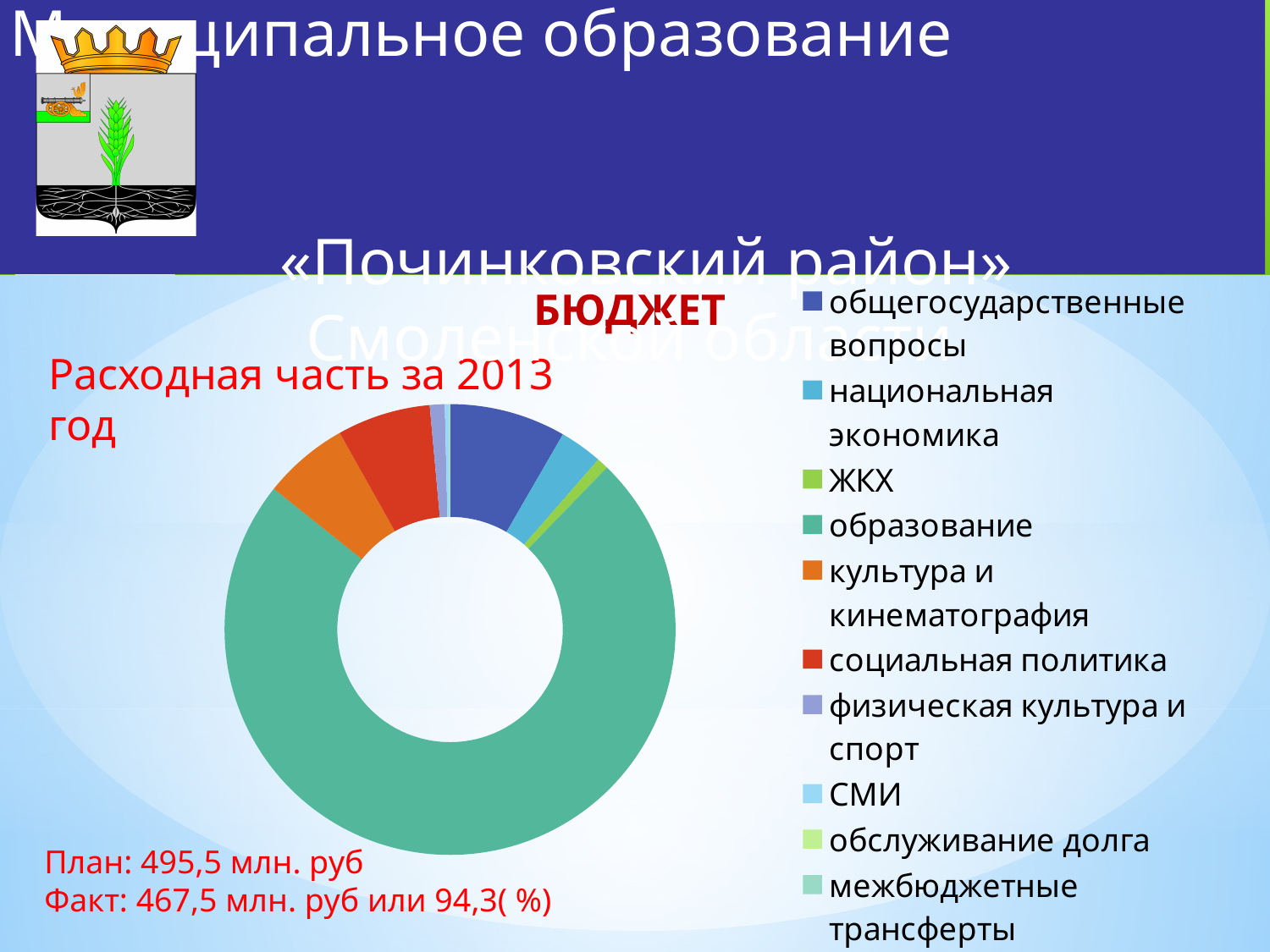
What kind of chart is shown on the slide? doughnut chart Which slice is larger: общегосударственные вопросы or ЖКХ? общегосударственные вопросы What is the title of the chart? БЮДЖЕТ How many categories does the chart legend list? 10 Which slice is larger: образование or социальная политика? образование Which slice is larger: образование or общегосударственные вопросы? образование Which category has the largest slice in the chart? образование What colour is the slice for образование? green